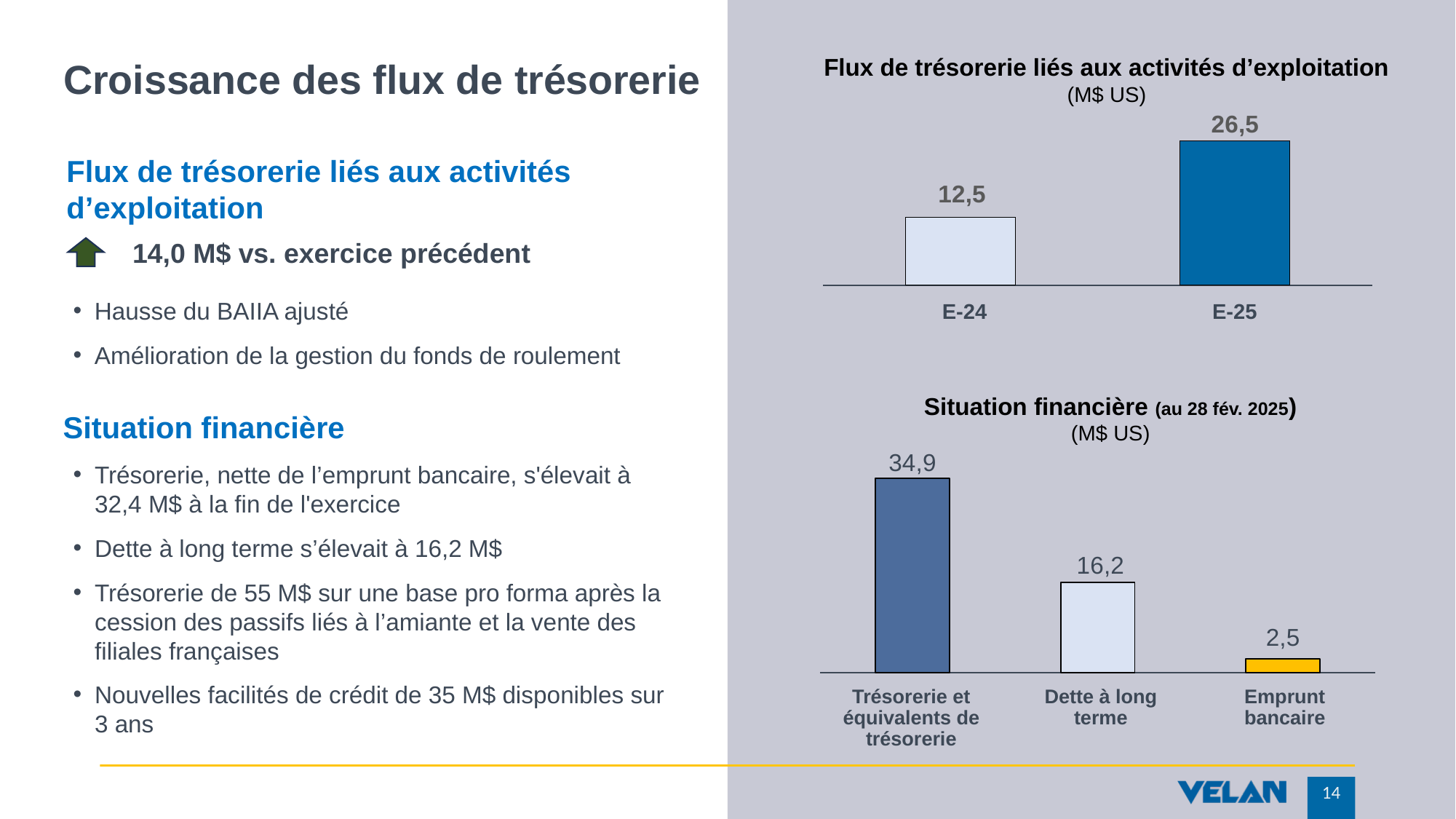
In the 'Situation financière' chart, what unit is shown under the title? M$ US In the 'Situation financière' chart, what is the difference between 'Trésorerie et équivalents de trésorerie' and 'Dette à long terme'? 18,7 In the 'Flux de trésorerie liés aux activités d'exploitation' chart, which year has the higher value? E-25 In the 'Situation financière' chart, which category has the lowest value? Emprunt bancaire In the 'Situation financière' chart, what is the value for 'Dette à long terme'? 16,2 In the 'Situation financière' chart, what is the value for 'Trésorerie et équivalents de trésorerie'? 34,9 In the 'Flux de trésorerie liés aux activités d'exploitation' chart, what is the difference between E-25 and E-24? 14,0 In the 'Situation financière' chart, what is the value for 'Emprunt bancaire'? 2,5 In the 'Flux de trésorerie liés aux activités d'exploitation' chart, what is the value for E-25? 26,5 In the 'Flux de trésorerie liés aux activités d'exploitation' chart, how many bars are plotted? 2 What kind of chart is the 'Flux de trésorerie liés aux activités d'exploitation' chart? Bar chart In the 'Flux de trésorerie liés aux activités d'exploitation' chart, what is the value for E-24? 12,5